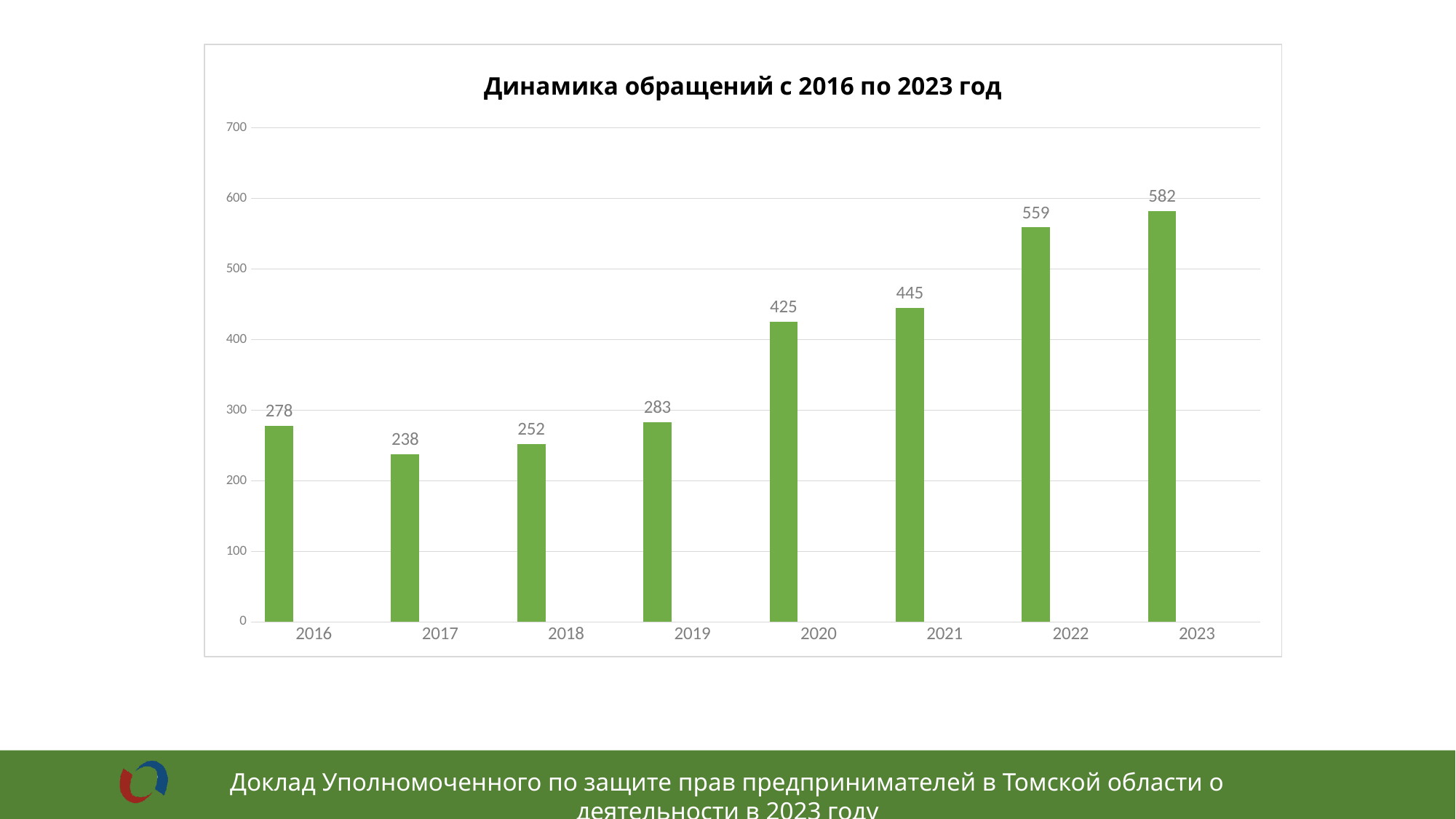
How many years are shown on the x axis? 8 What is the difference between the values for 2022 and 2021? 114 What is the title of the chart? Динамика обращений с 2016 по 2023 год Is the value for 2021 greater or less than 400? greater What kind of chart is this? bar chart Which year has the lowest value? 2017 Which is larger, the value for 2018 or the value for 2019? 2019 Which year has the highest value? 2023 What is the value for 2020? 425 What is the value for 2023? 582 What is the difference between the values for 2023 and 2016? 304 What is the value for 2016? 278